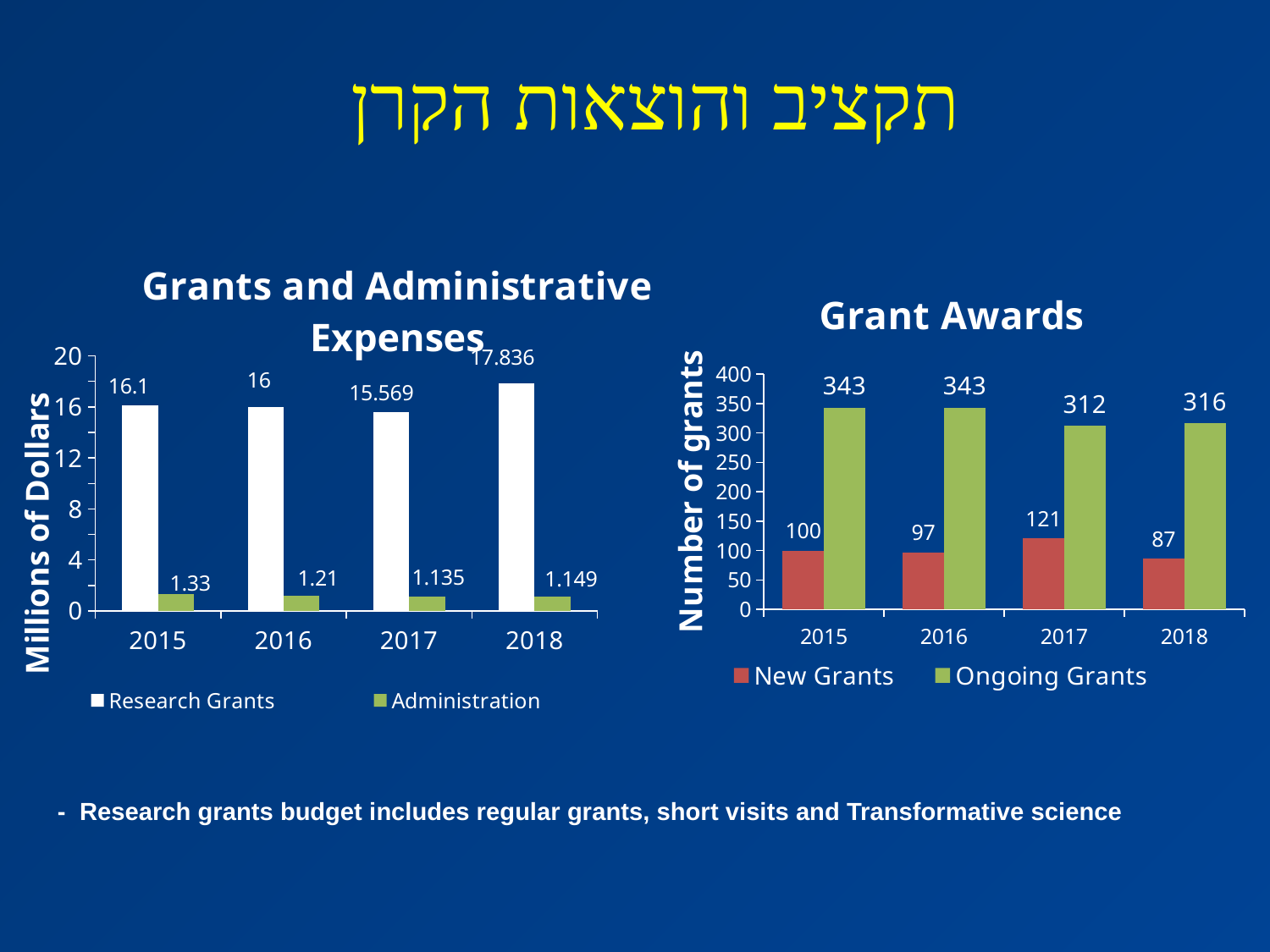
In the 'Grants and Administrative Expenses' chart, what is the value for Research Grants in 2018? 17.836 In the 'Grants and Administrative Expenses' chart, how many series does the legend list? 2 In the 'Grant Awards' chart, which year has the lowest number of New Grants? 2018 In the 'Grant Awards' chart, how many years are shown on the x axis? 4 In the 'Grants and Administrative Expenses' chart, what is the difference between Research Grants in 2018 and 2017? 2.267 In the 'Grants and Administrative Expenses' chart, what is the value for Administration in 2015? 1.33 In the 'Grant Awards' chart, what is the number of Ongoing Grants in 2018? 316 What kind of chart is the 'Grant Awards' chart? bar chart In the 'Grants and Administrative Expenses' chart, which year has the lowest Research Grants value? 2017 In the 'Grant Awards' chart, what is the number of New Grants in 2017? 121 In the 'Grant Awards' chart, what is the difference between Ongoing Grants in 2016 and 2017? 31 In the 'Grant Awards' chart, is the number of New Grants in 2015 larger or smaller than in 2016? larger